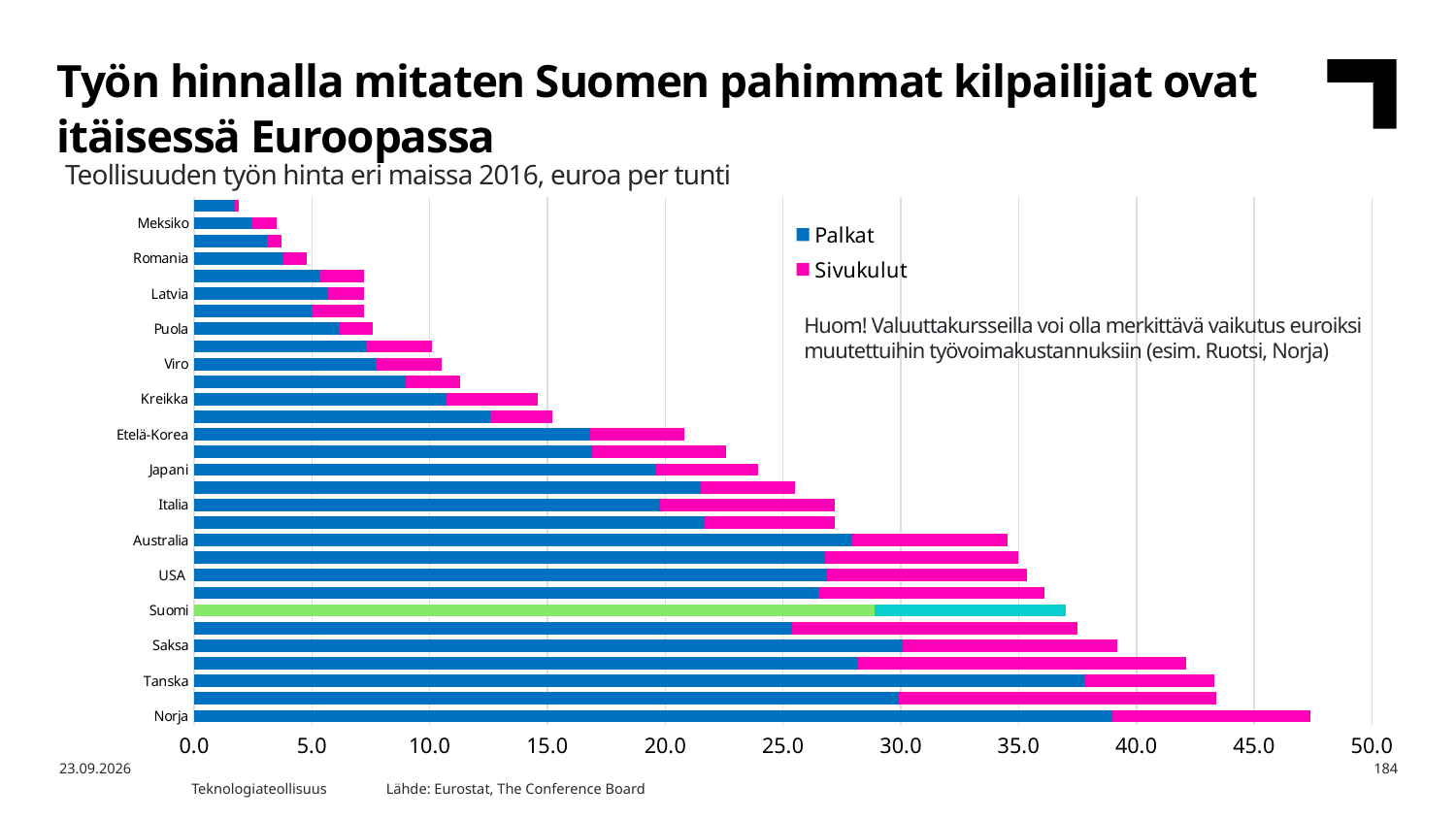
What kind of chart is shown on the slide? Stacked bar chart What are the two series named in the legend? Palkat and Sivukulut Is the total value for Norja greater or less than 45.0? greater Which has the larger total labour cost, Tanska or Saksa? Tanska Is the total value for Tanska greater or less than 40.0? greater Is the total value for Japani greater or less than 25.0? less Which labelled country has the lowest total labour cost per hour? Meksiko How many series does the legend list? 2 Which labelled country has the highest total labour cost per hour? Norja Which country's bar is highlighted in a different colour (green) from the others? Suomi